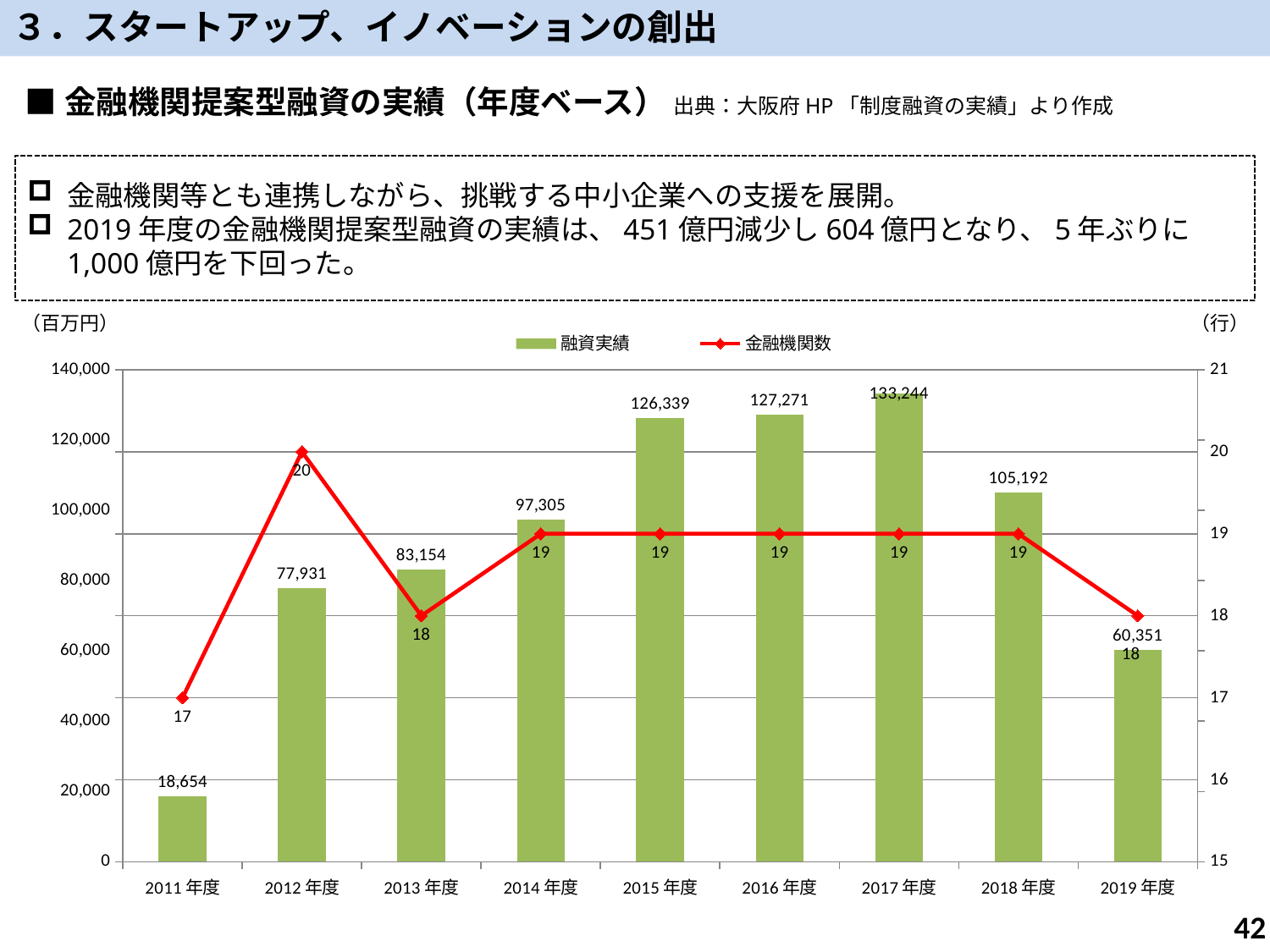
What is the difference in 融資実績 between 2017年度 and 2016年度? 5,973 What kind of chart is this? Combined bar and line chart Which is larger, the 融資実績 for 2013年度 or for 2014年度? 2014年度 Is the 融資実績 for 2019年度 greater or less than 80,000? less What is the 金融機関数 value for 2012年度? 20 How many series does the legend list? 2 What is the difference in 融資実績 between 2018年度 and 2019年度? 44,841 What is the 融資実績 value for 2015年度? 126,339 Which year has the highest 融資実績? 2017年度 Which year has the lowest 融資実績? 2011年度 How many fiscal years are shown on the x axis? 9 Which year has the lowest 金融機関数? 2011年度